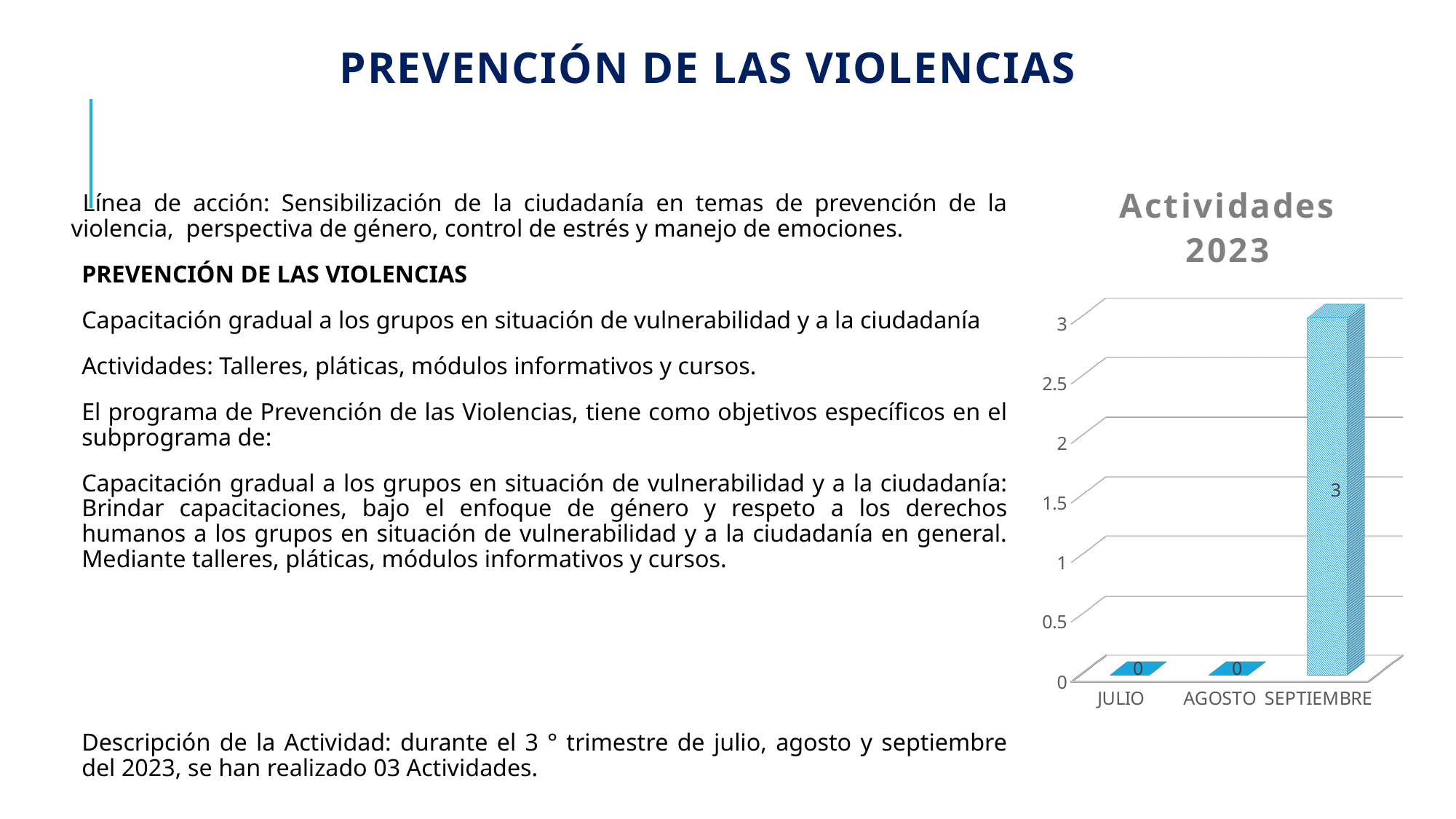
Is the value for SEPTIEMBRE in the Actividades 2023 chart greater or less than 2? greater What is the difference between the values for SEPTIEMBRE and AGOSTO in the Actividades 2023 chart? 3 Which month has the highest value in the Actividades 2023 chart? SEPTIEMBRE What is the value for SEPTIEMBRE in the Actividades 2023 chart? 3 What is the title of the chart on the slide? Actividades 2023 What is the highest tick value shown on the vertical axis of the Actividades 2023 chart? 3 What is the value for AGOSTO in the Actividades 2023 chart? 0 Which is larger in the Actividades 2023 chart, the value for JULIO or the value for SEPTIEMBRE? SEPTIEMBRE Do the values in the Actividades 2023 chart rise or fall from JULIO to SEPTIEMBRE? rise How many months are shown on the x axis of the Actividades 2023 chart? 3 What kind of chart is the Actividades 2023 chart? bar chart What is the value for JULIO in the Actividades 2023 chart? 0